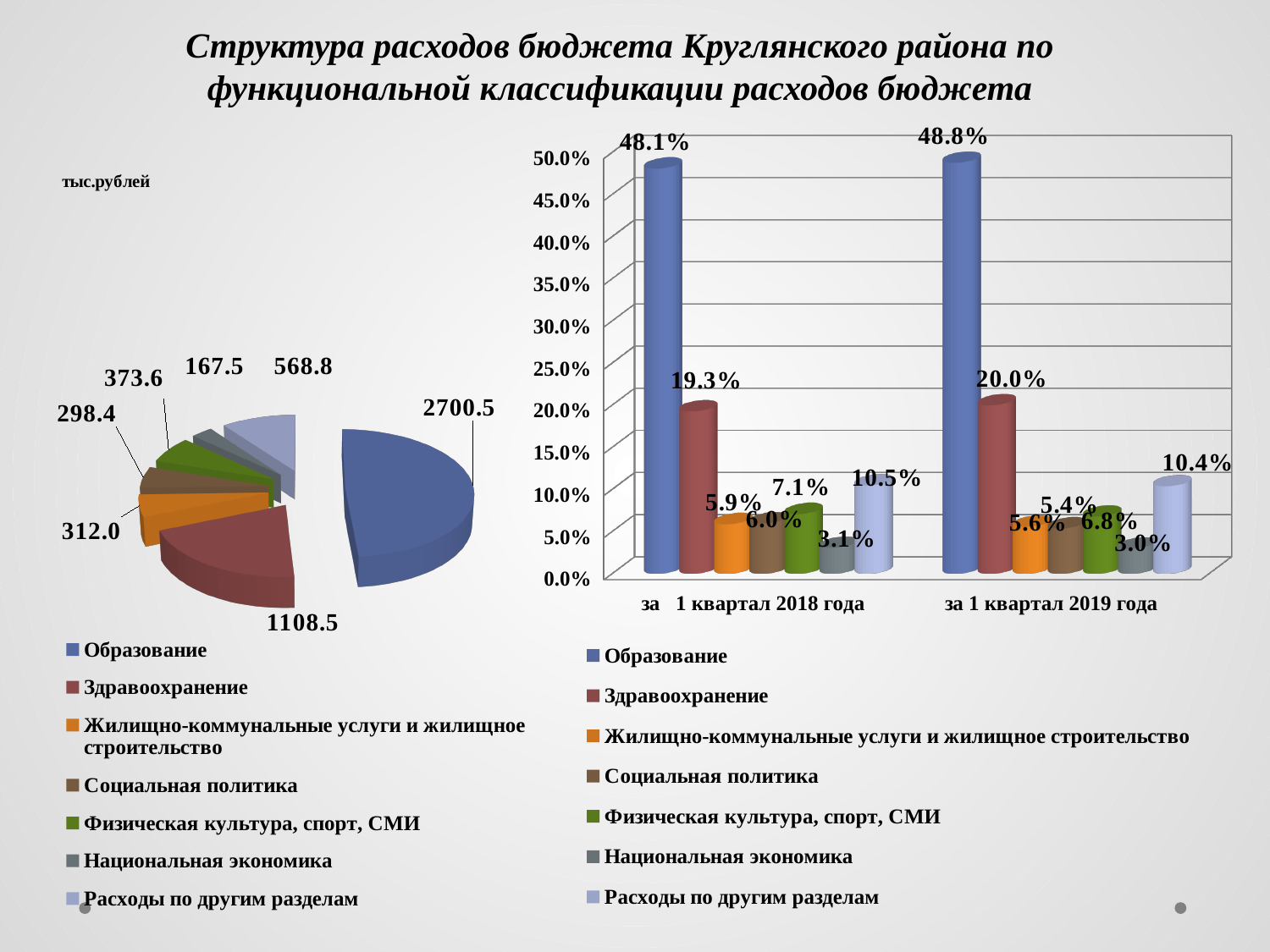
What kind of chart is shown on the right side of the slide? bar chart In the bar chart on the right, what is the value for Здравоохранение за 1 квартал 2018 года? 19.3% In the bar chart on the right, how many series does the legend list? 7 In the bar chart on the right, what is the value for Образование за 1 квартал 2019 года? 48.8% In the bar chart on the right, which category has the lowest value за 1 квартал 2019 года? Национальная экономика In the pie chart on the left, what is the difference between the values for Образование and Здравоохранение? 1592.0 In the pie chart on the left, what unit is shown above the chart? тыс.рублей In the bar chart on the right, which is larger: Расходы по другим разделам за 1 квартал 2018 года or за 1 квартал 2019 года? за 1 квартал 2018 года In the pie chart on the left, what is the value for Здравоохранение? 1108.5 In the pie chart on the left, what is the value for Образование? 2700.5 In the pie chart on the left, which category has the smallest value? Национальная экономика In the pie chart on the left, how many slices are there? 7